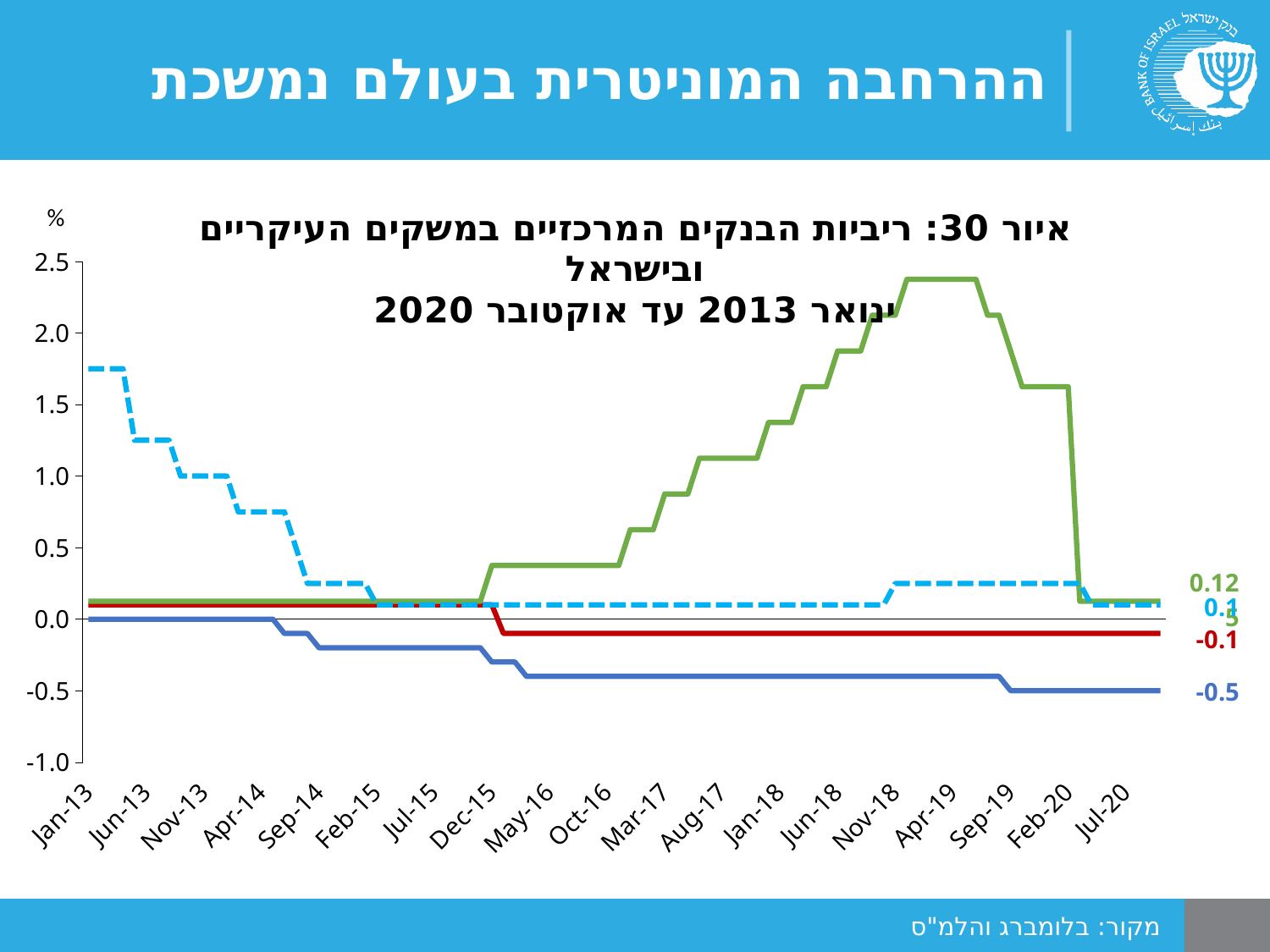
Which line has the lowest value at the end of the period? the solid dark blue line How many lines are plotted on the chart? 4 What type of chart is shown on the slide? line chart What is the final value labelled at the right end of the solid dark blue line? -0.5 What unit is shown at the top of the y axis? % Is the value of the dashed light blue line at Jan-13 greater or less than 1.5? greater At the end of the period, which is higher: the red line or the solid dark blue line? the red line Which line reaches the highest value on the chart? the green line Is the peak value of the green line greater or less than 2.0? greater What is the final value labelled at the right end of the green line? 0.12 What is the final value labelled at the right end of the red line? -0.1 What is the difference between the final value of the green line (0.12) and the final value of the solid dark blue line (-0.5)? 0.62